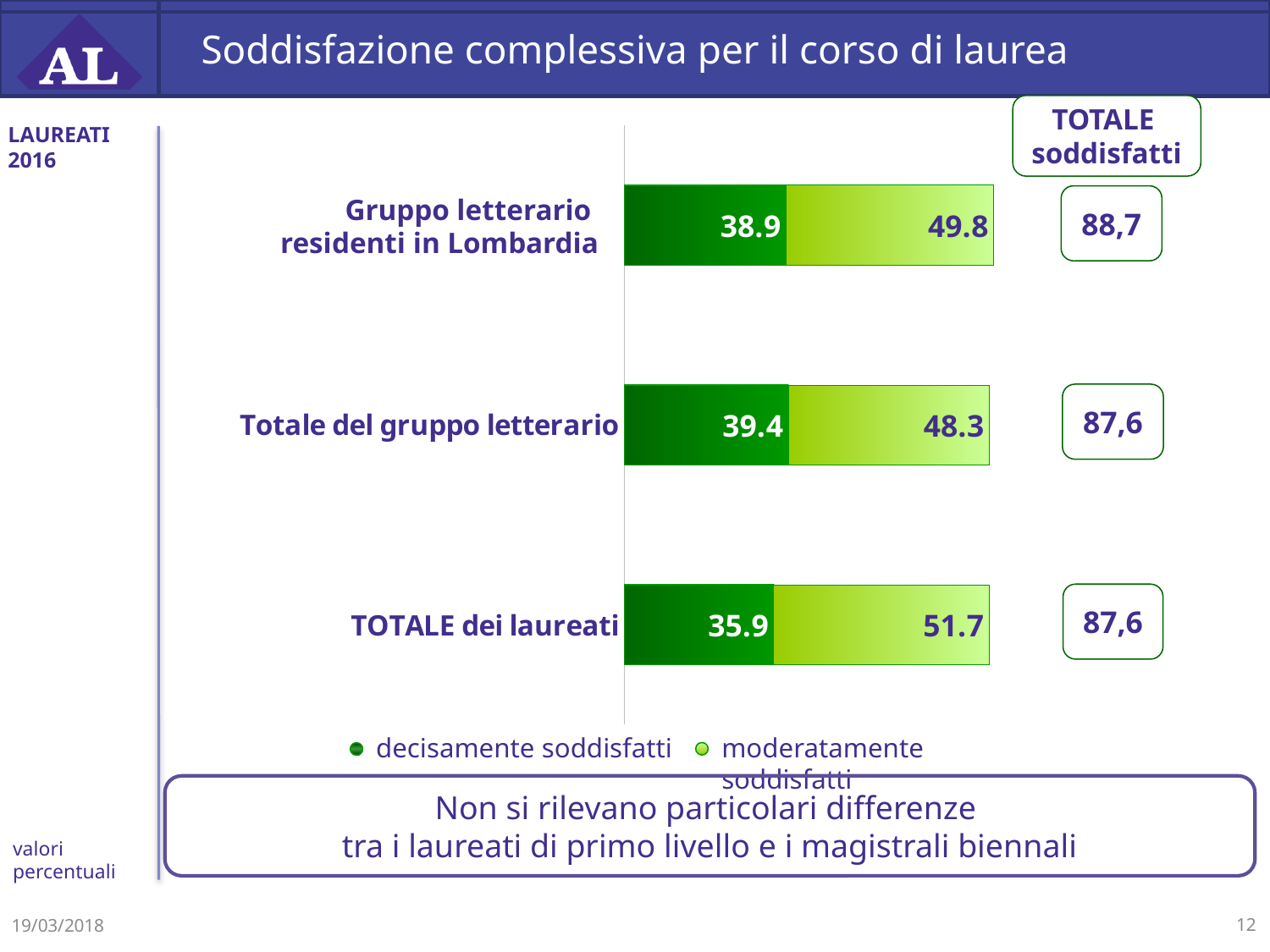
Which category has the highest value for 'decisamente soddisfatti'? Totale del gruppo letterario Which is larger: the 'decisamente soddisfatti' value for 'Gruppo letterario residenti in Lombardia' or for 'TOTALE dei laureati'? Gruppo letterario residenti in Lombardia What kind of chart is shown on the slide? Stacked bar chart What is the value for 'moderatamente soddisfatti' for 'TOTALE dei laureati'? 51.7 How many series does the legend list? 2 What is the value for 'decisamente soddisfatti' for 'Gruppo letterario residenti in Lombardia'? 38.9 What is the difference between the 'moderatamente soddisfatti' values for 'TOTALE dei laureati' and 'Totale del gruppo letterario'? 3.4 Which category has the highest value for 'moderatamente soddisfatti'? TOTALE dei laureati Which category has the lowest value for 'decisamente soddisfatti'? TOTALE dei laureati What is the total of the stacked bar for 'Gruppo letterario residenti in Lombardia'? 88,7 What is the value for 'moderatamente soddisfatti' for 'Totale del gruppo letterario'? 48.3 How many categories are shown in the chart? 3